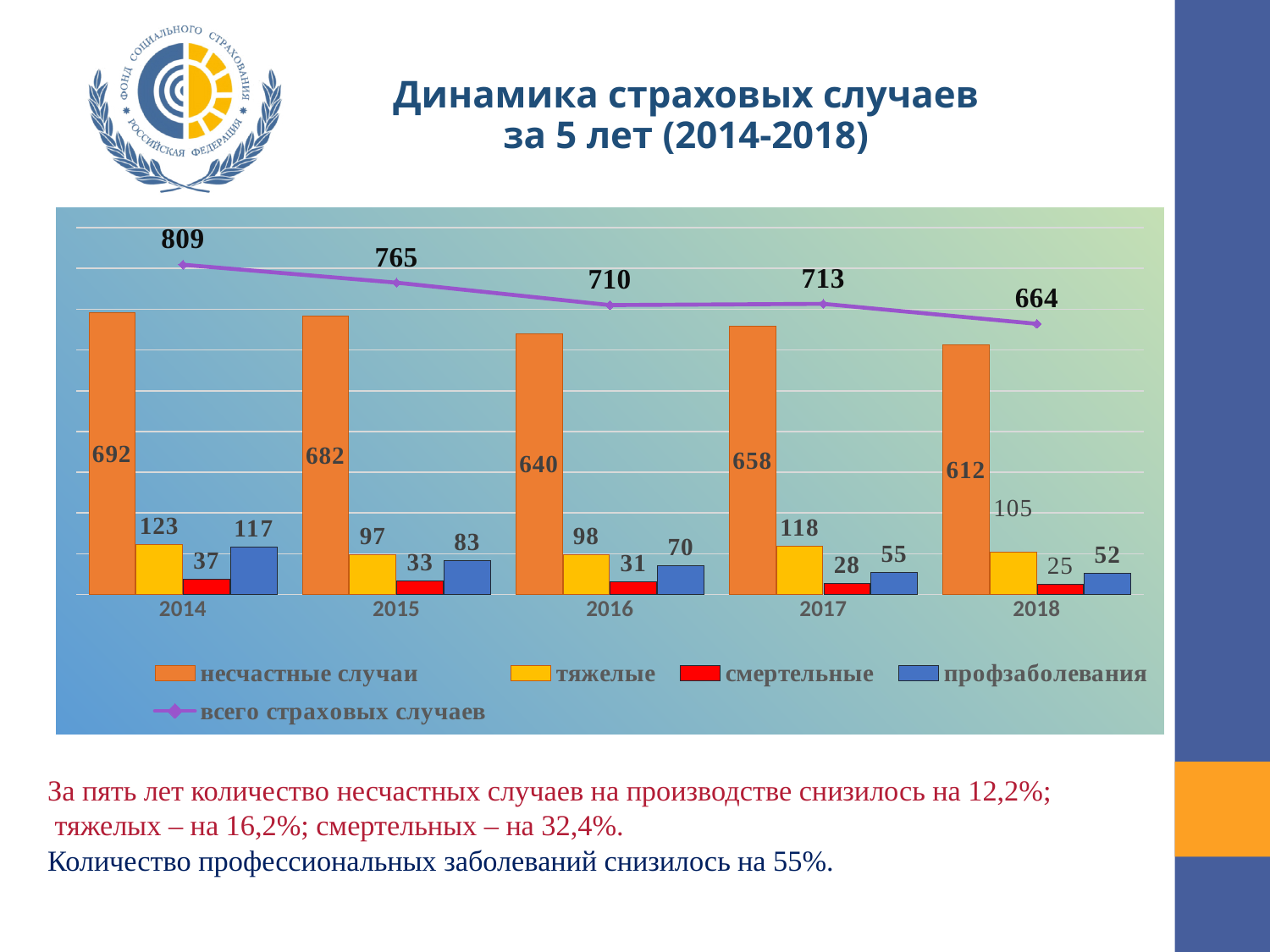
What is the value of всего страховых случаев in 2018? 664 In which year is смертельные lowest? 2018 How many series does the legend list? 5 Does the value of профзаболевания rise or fall from 2014 to 2018? Fall Which is larger: тяжелые in 2015 or тяжелые in 2017? тяжелые in 2017 What kind of chart is shown on the slide? Combined bar and line chart What is the difference between всего страховых случаев in 2014 and in 2018? 145 How many years are shown on the x axis? 5 What is the value of смертельные in 2017? 28 In which year is всего страховых случаев highest? 2014 What is the value of профзаболевания in 2016? 70 What is the value of несчастные случаи in 2014? 692